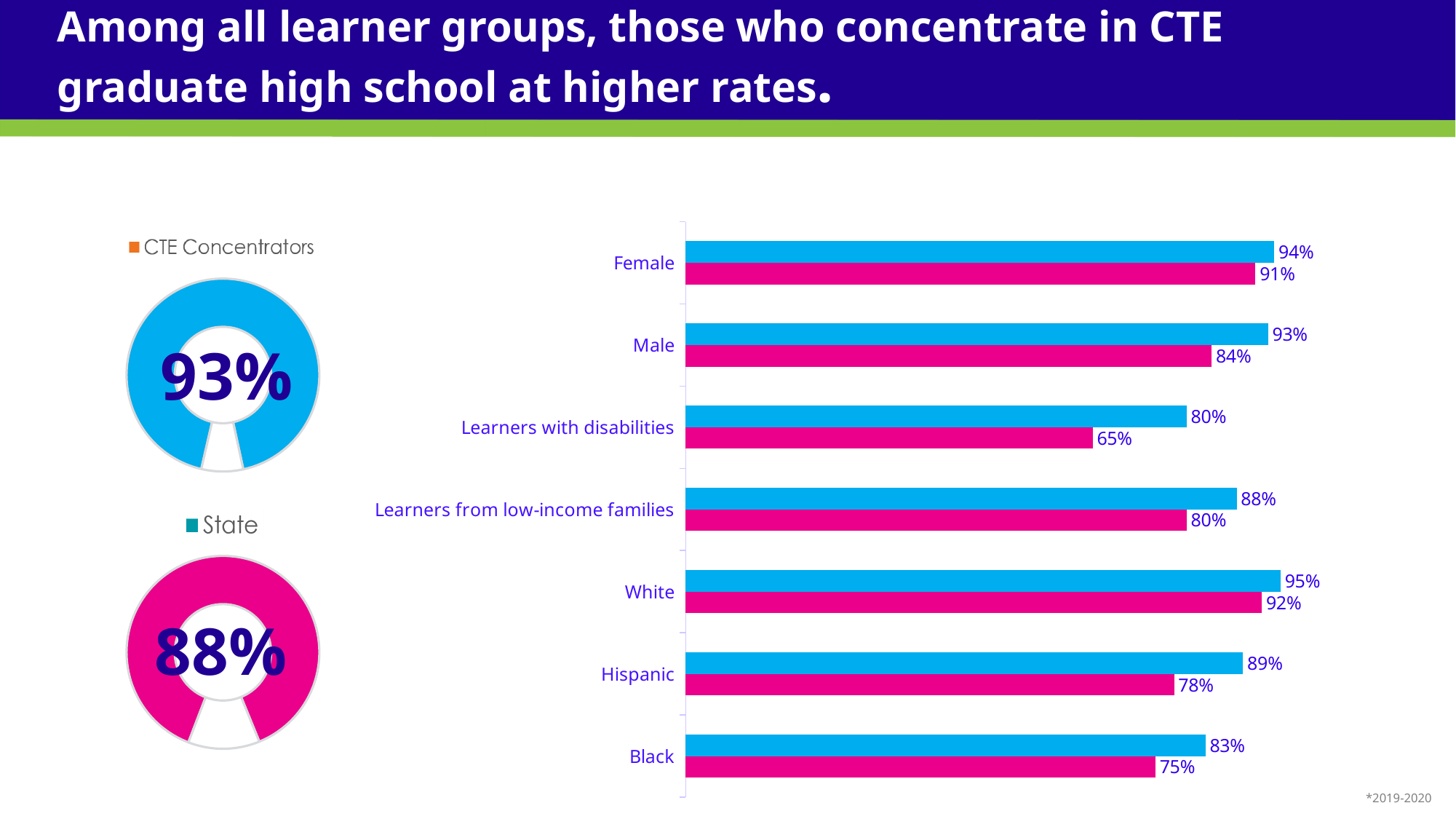
In the bar chart, which learner group has the lowest pink (State) value? Learners with disabilities In the bar chart, what is the value of the pink (State) bar for Learners with disabilities? 65% In the bar chart, what is the difference between the blue and pink bars for Male? 9% In the bar chart, what is the value of the blue (CTE Concentrators) bar for Hispanic? 89% What kind of chart is shown on the right side of the slide? Bar chart How many learner groups are shown in the bar chart? 7 In the bar chart, what is the difference between the blue and pink bars for Black? 8% In the bar chart, what is the value of the blue (CTE Concentrators) bar for Female? 94% In the bar chart, which learner group has the highest blue (CTE Concentrators) value? White In the bar chart, which is larger: the pink (State) value for White or the pink (State) value for Hispanic? White What percentage is shown in the CTE Concentrators donut chart on the left? 93% What percentage is shown in the State donut chart on the left? 88%